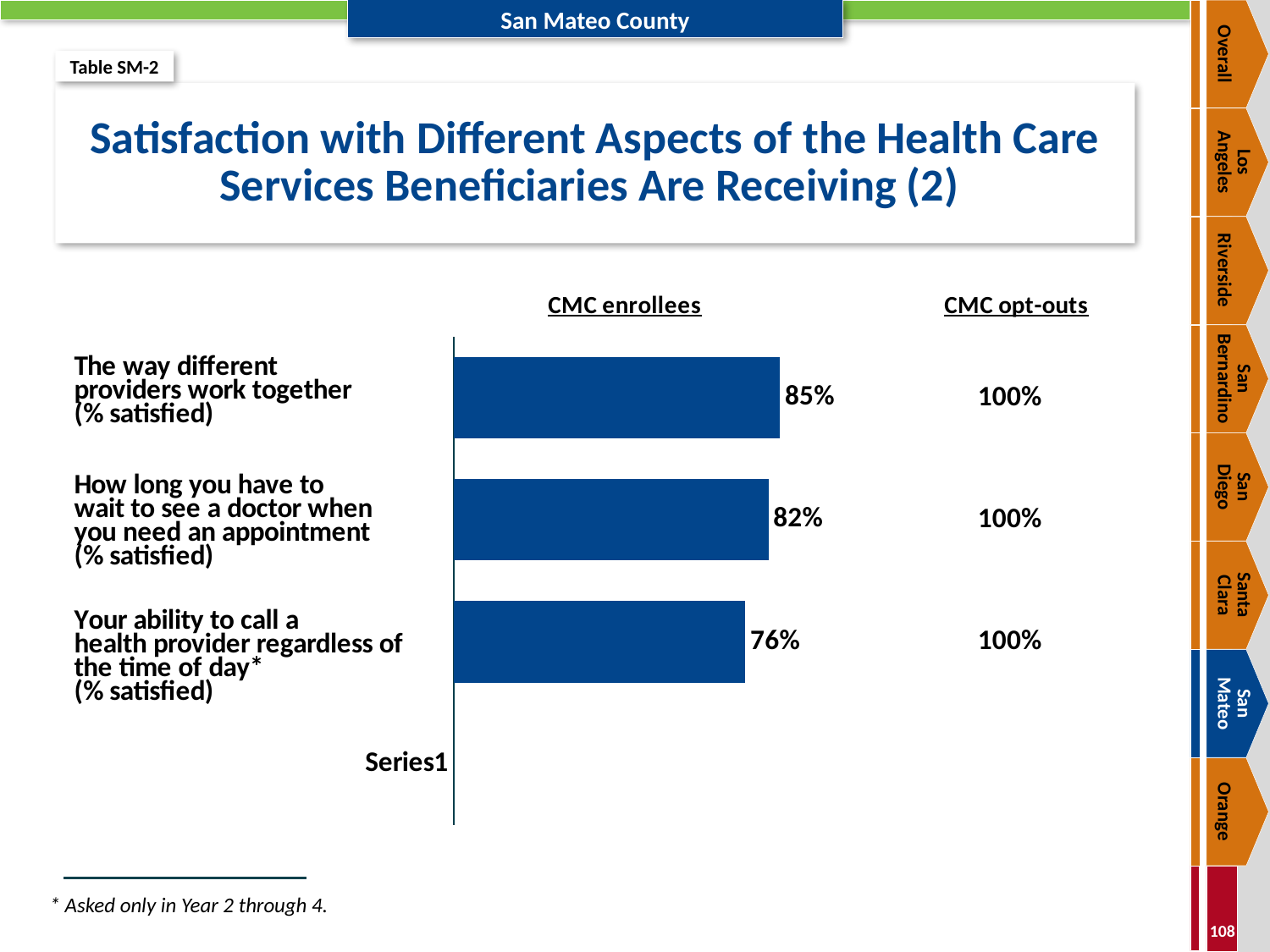
What is the CMC enrollees value for 'The way different providers work together (% satisfied)'? 85% Which aspect has the highest CMC enrollees satisfaction? The way different providers work together What is the title of the chart on the slide? Satisfaction with Different Aspects of the Health Care Services Beneficiaries Are Receiving (2) What is the CMC enrollees value for 'Your ability to call a health provider regardless of the time of day (% satisfied)'? 76% Which aspect has the lowest CMC enrollees satisfaction? Your ability to call a health provider regardless of the time of day What is the CMC enrollees value for 'How long you have to wait to see a doctor when you need an appointment (% satisfied)'? 82% What kind of chart is shown on the slide? Bar chart What is the difference between the CMC opt-outs and CMC enrollees values for 'How long you have to wait to see a doctor when you need an appointment'? 18% What is the difference between the CMC enrollees values for 'The way different providers work together' and 'Your ability to call a health provider regardless of the time of day'? 9% What is the CMC opt-outs value for 'The way different providers work together (% satisfied)'? 100% Which is larger for 'The way different providers work together': the CMC enrollees value or the CMC opt-outs value? CMC opt-outs How many aspects of health care services are shown in the chart? 3